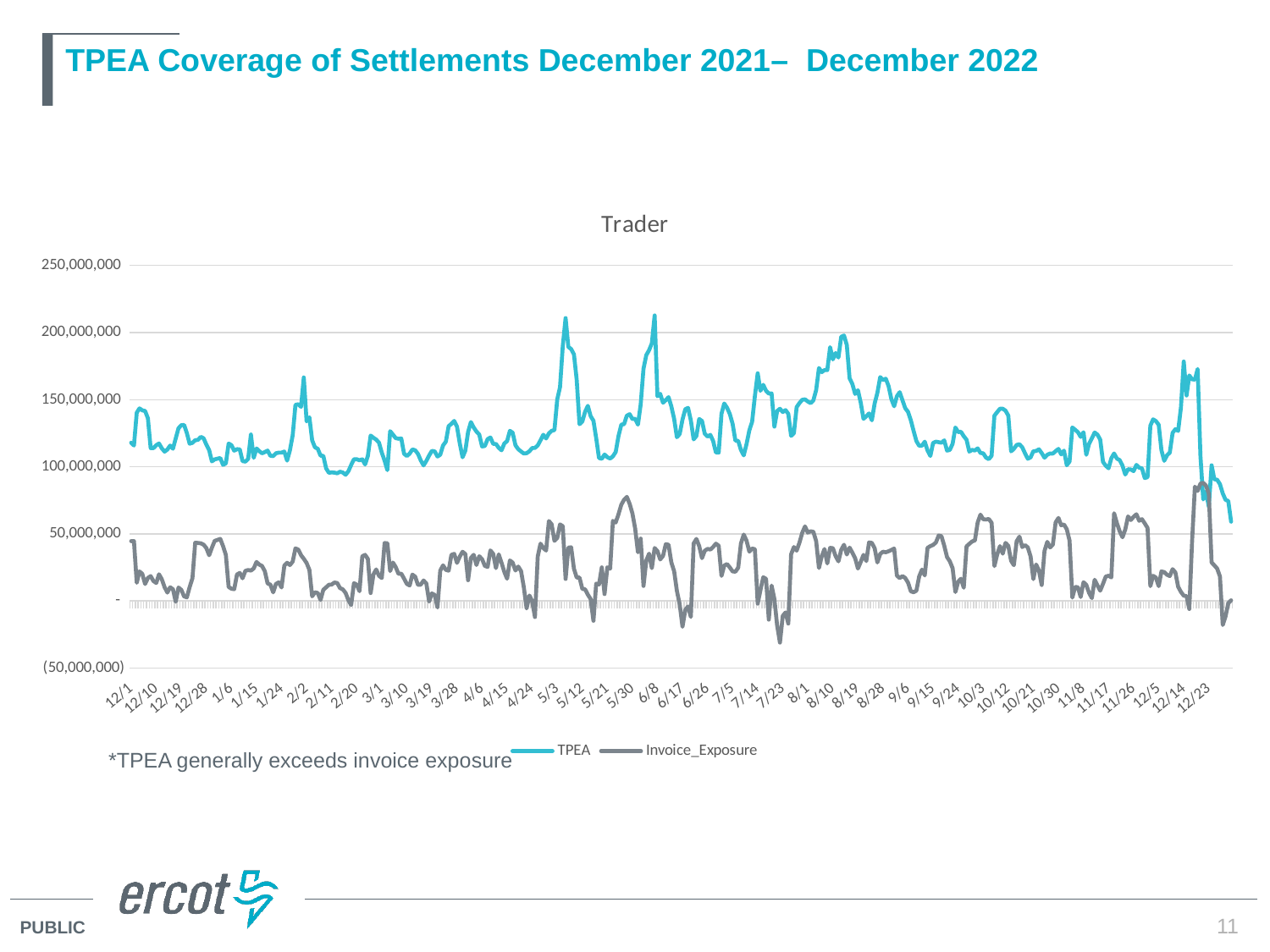
What is the title printed above the chart? Trader How many series does the chart legend list? 2 Which series is higher around 8/19, TPEA or Invoice_Exposure? TPEA What are the two series named in the chart legend? TPEA and Invoice_Exposure Is the TPEA value at 12/1 greater or less than 100,000,000? greater What kind of chart is shown on the slide? line chart Is the TPEA value around 10/12 greater or less than 150,000,000? less Is the peak TPEA value around 5/3 greater or less than 200,000,000? greater Which series is higher at 12/1, TPEA or Invoice_Exposure? TPEA